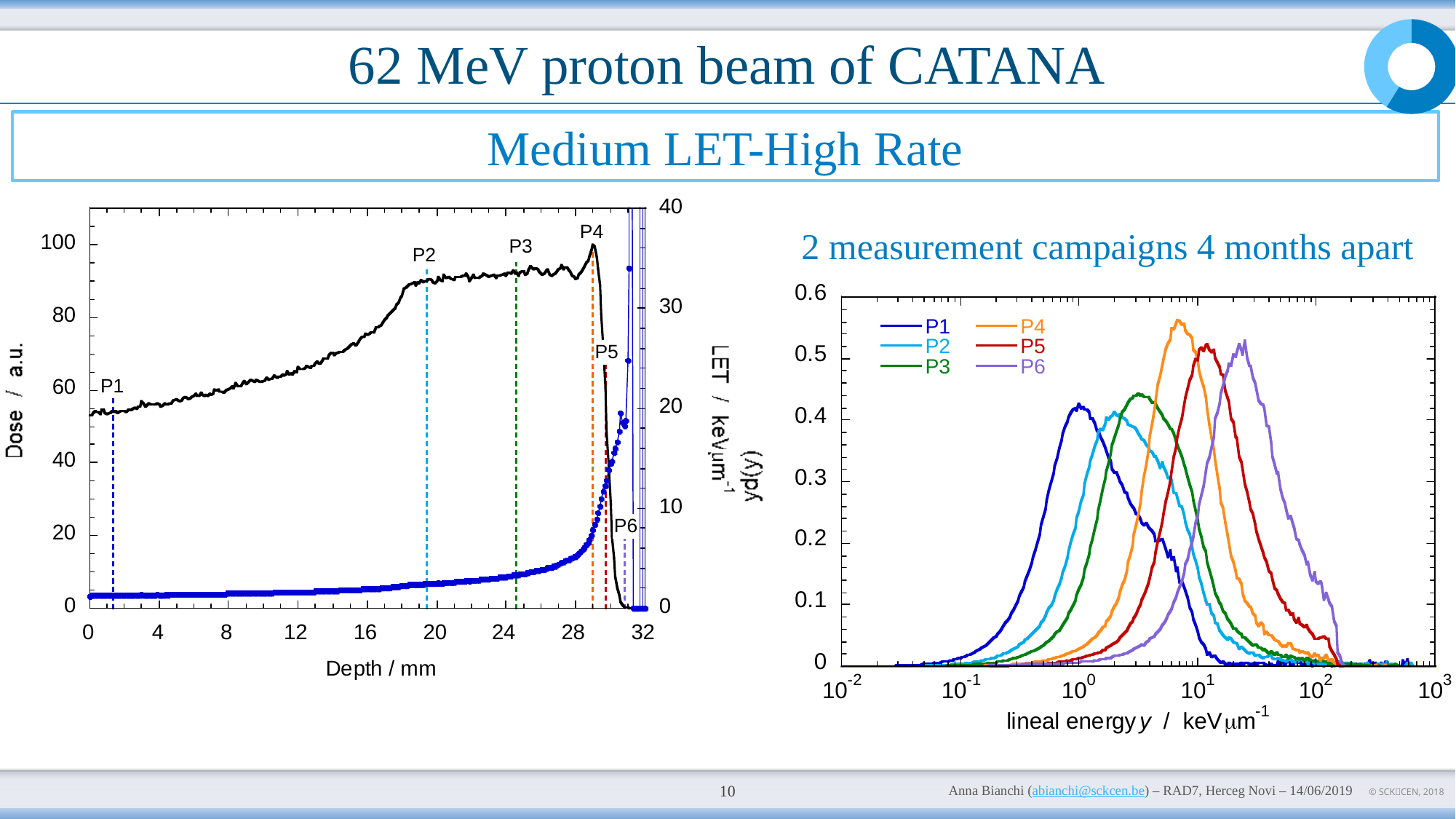
On the left chart, does the dose rise or fall with depth between 0 mm and 28 mm? rise On the left chart, how many labelled positions (P1 to P6) are marked with dashed lines? 6 On the right chart, what is the label of the x axis? lineal energy y / keV µm-1 On the right chart, which series peaks at a higher lineal energy, P1 or P6? P6 On the right chart (yd(y) vs lineal energy), how many series does the legend list? 6 On the left chart (Dose vs Depth), what kind of chart is it? line chart On the left chart, what is the label of the x axis? Depth / mm On the right chart, is the peak value of P1 greater or less than 0.5? less On the right chart, is the peak value of P4 greater or less than 0.5? greater On the left chart, is the dose at position P1 greater or less than 40? greater On the right chart, which series has the highest peak? P4